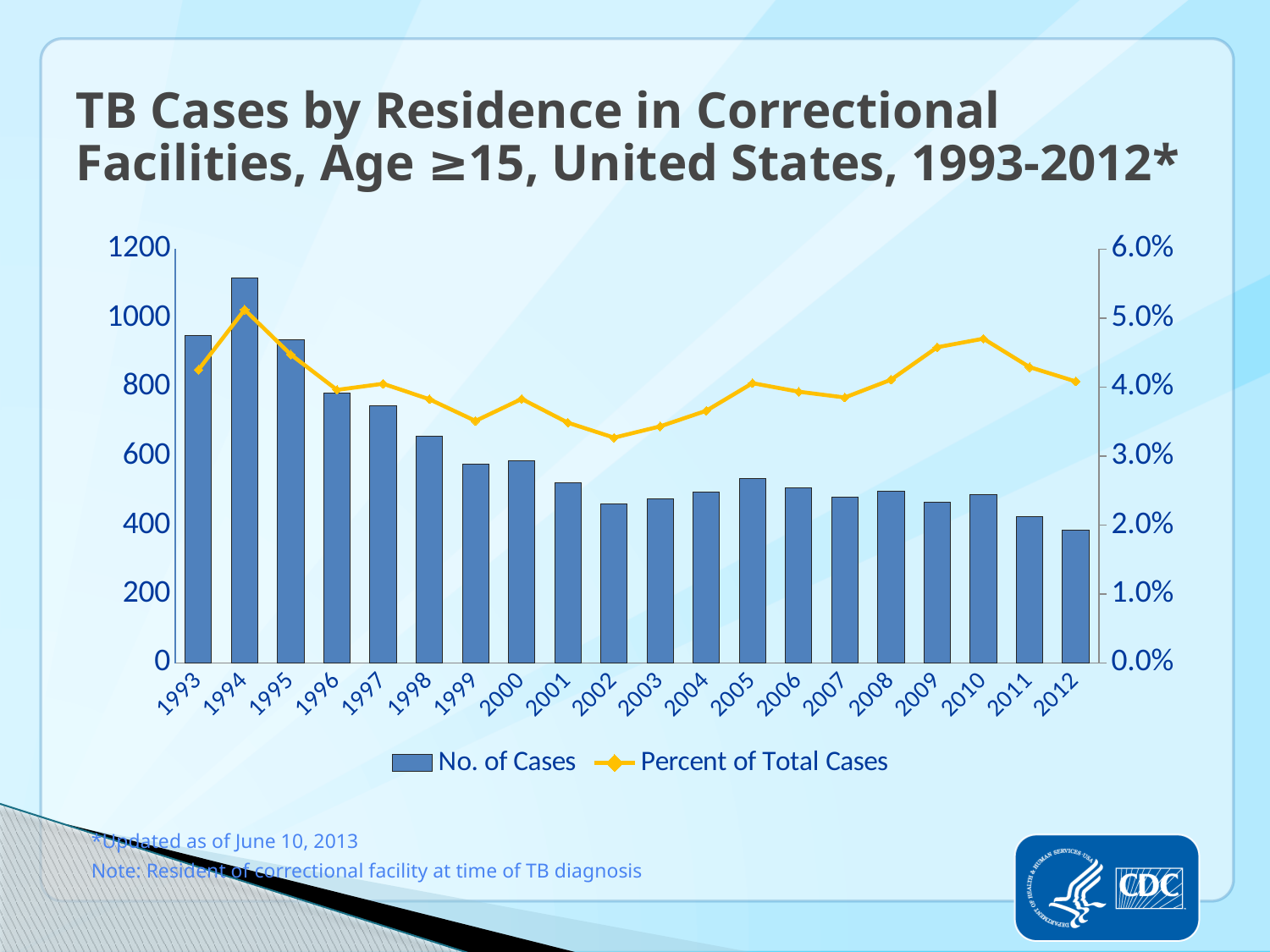
Which year has the highest number of cases? 1994 Does the number of cases generally rise or fall from 1994 to 2012? Fall How many years are shown on the x axis? 20 How many series does the legend list? 2 Which year has more cases, 1993 or 2001? 1993 What kind of chart is used to show the number of cases? Bar chart In which year is the Percent of Total Cases highest? 1994 Is the number of cases in 2012 greater or less than 400? less Is the number of cases in 1994 greater or less than 1000? greater In which year is the Percent of Total Cases lowest? 2002 Which year has the lowest number of cases? 2012 Is the Percent of Total Cases in 2010 greater or less than 4.0%? greater